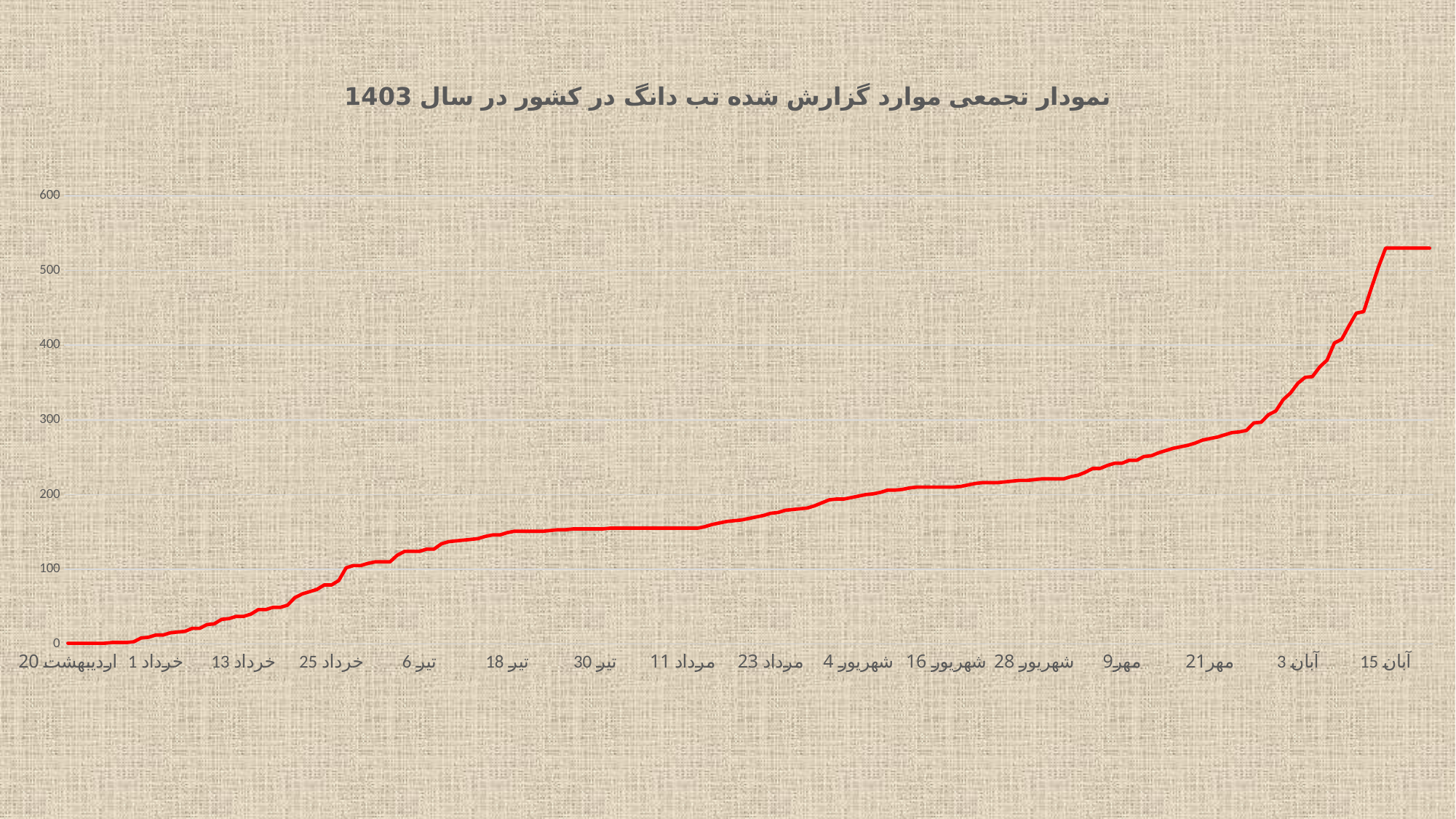
Do the values rise or fall along the x axis from 20 اردیبهشت to 15 آبان? rise Is the value at 15 آبان greater or less than 500? greater Is the value at 30 تیر greater or less than 200? less What kind of chart is shown on the slide? line chart At which x-axis date is the plotted value lowest? 20 اردیبهشت Is the value at 6 تیر greater or less than 100? greater What is the title of the chart? نمودار تجمعی موارد گزارش شده تب دانگ در کشور در سال 1403 What colour is the plotted line? red Which is larger, the value at 9 مهر or the value at 6 تیر? 9 مهر At which x-axis date is the plotted value highest? 15 آبان